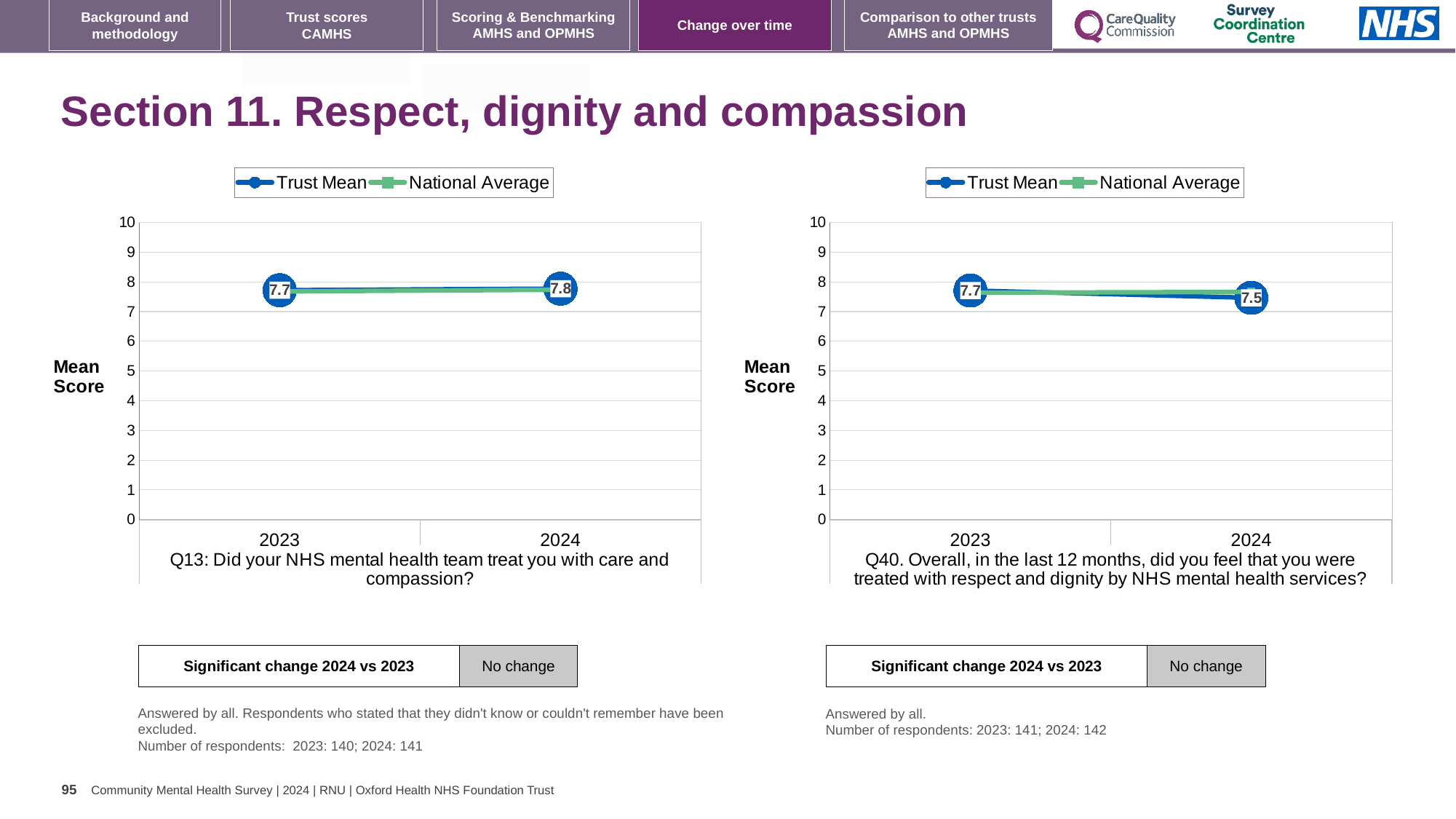
In the left chart (Q13), is the National Average for 2024 greater or less than 5? greater In the left chart (Q13), what is the Trust Mean for 2024? 7.8 What kind of chart is the left chart (Q13)? line chart In the right chart (Q40), what is the Trust Mean for 2024? 7.5 Which chart has the higher Trust Mean in 2024, the left chart (Q13) or the right chart (Q40)? the left chart (Q13) How many years are plotted on the x axis of the right chart (Q40)? 2 In the right chart (Q40), what is the Trust Mean for 2023? 7.7 In the right chart (Q40), does the Trust Mean rise or fall from 2023 to 2024? fall In the left chart (Q13), does the Trust Mean rise or fall from 2023 to 2024? rise In the right chart (Q40), by how much did the Trust Mean change from 2023 to 2024? 0.2 How many series does the legend of the left chart (Q13) list? 2 In the left chart (Q13), what is the Trust Mean for 2023? 7.7